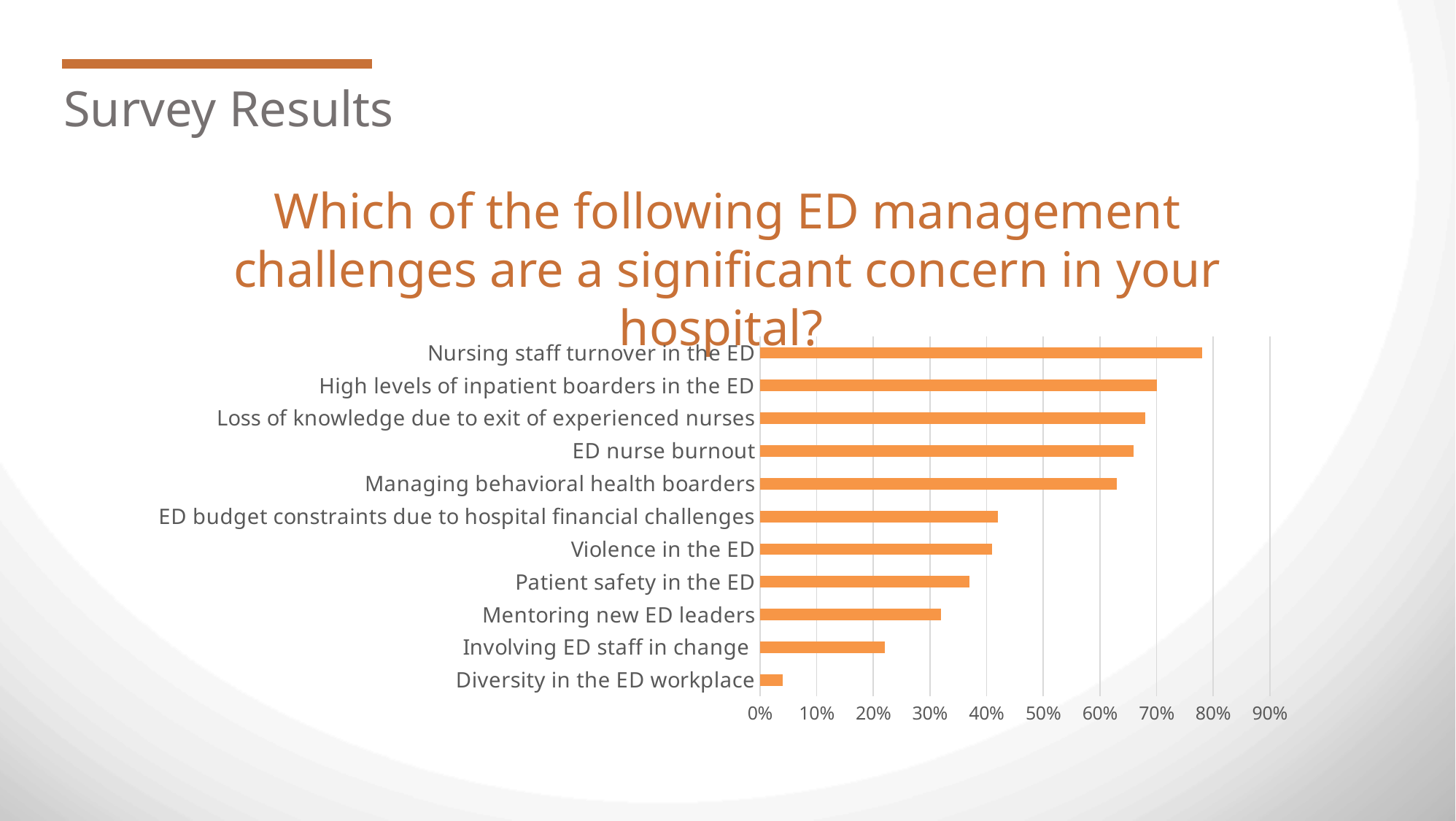
Which is larger: the value for Managing behavioral health boarders or the value for ED budget constraints due to hospital financial challenges? Managing behavioral health boarders Is the value for ED nurse burnout greater or less than 60%? greater Do the bar lengths increase or decrease going from the top category to the bottom category? decrease Is the value for Nursing staff turnover in the ED greater or less than 70%? greater Which is larger: the value for Patient safety in the ED or the value for Mentoring new ED leaders? Patient safety in the ED What kind of chart is shown on the slide? bar chart How many ED management challenges are listed in the chart? 11 Which challenge has the highest percentage in the chart? Nursing staff turnover in the ED What colour are the bars in the chart? orange Is the value for Involving ED staff in change greater or less than 30%? less Which challenge has the lowest percentage in the chart? Diversity in the ED workplace